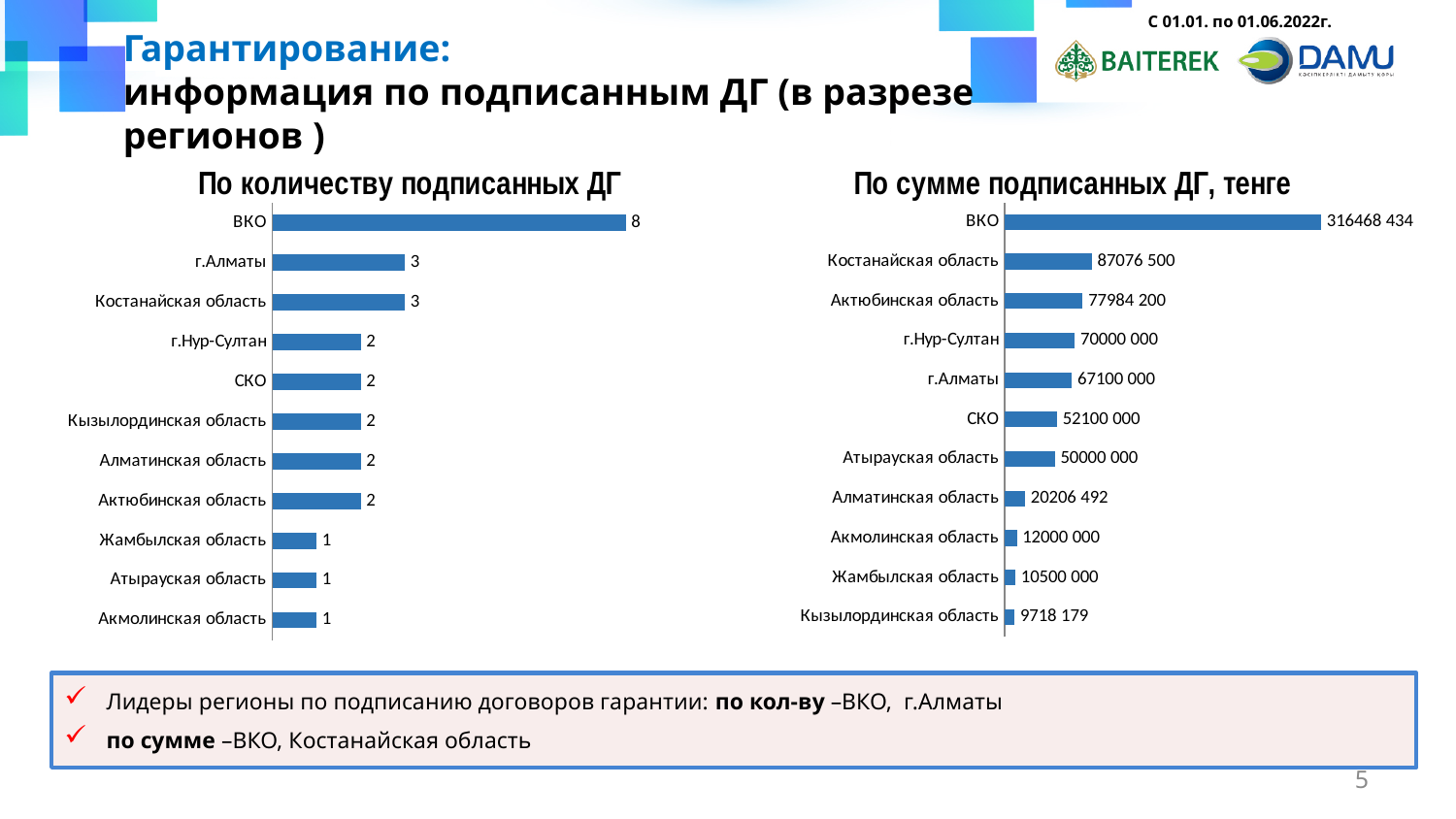
In the chart 'По сумме подписанных ДГ, тенге', what is the value for Костанайская область? 87076 500 In the chart 'По сумме подписанных ДГ, тенге', which is larger: г.Нур-Султан or г.Алматы? г.Нур-Султан In the chart 'По количеству подписанных ДГ', what is the difference between ВКО and г.Алматы? 5 In the chart 'По количеству подписанных ДГ', what is the value for ВКО? 8 In the chart 'По количеству подписанных ДГ', what is the value for Костанайская область? 3 What type of chart is 'По сумме подписанных ДГ, тенге'? Bar chart In the chart 'По количеству подписанных ДГ', which region has the highest value? ВКО In the chart 'По количеству подписанных ДГ', how many regions are shown? 11 What is the title of the chart on the left side of the slide? По количеству подписанных ДГ In the chart 'По сумме подписанных ДГ, тенге', what is the difference between Акмолинская область and Жамбылская область? 1500 000 In the chart 'По сумме подписанных ДГ, тенге', what is the value for Кызылординская область? 9718 179 In the chart 'По сумме подписанных ДГ, тенге', which region has the lowest value? Кызылординская область